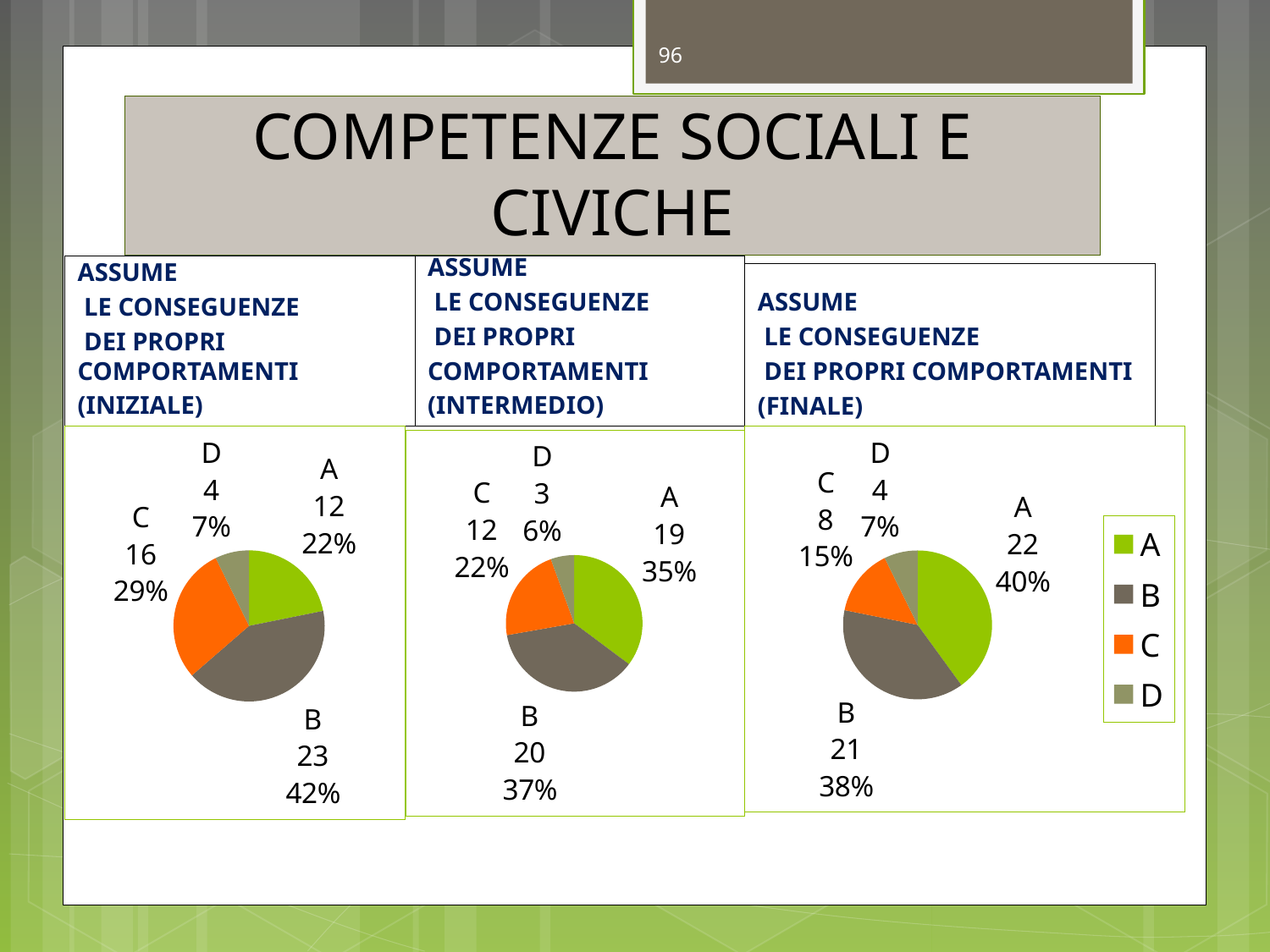
In the FINALE pie chart, which category has the largest share? A In the INTERMEDIO pie chart, what is the count for category A? 19 In the INIZIALE pie chart, what is the count for category B? 23 In the INTERMEDIO pie chart, what is the difference between the counts for B and C? 8 In the INIZIALE pie chart, what percentage share does category C have? 29% What type of chart is used on this slide? Pie chart In the FINALE pie chart, what is the difference between the counts for A and D? 18 In the FINALE pie chart, what percentage share does category B have? 38% In the INIZIALE pie chart, which category has the smallest share? D In the INTERMEDIO pie chart, what percentage share does category D have? 6% In the FINALE pie chart, what is the count for category C? 8 How many categories does the legend on the right list? 4